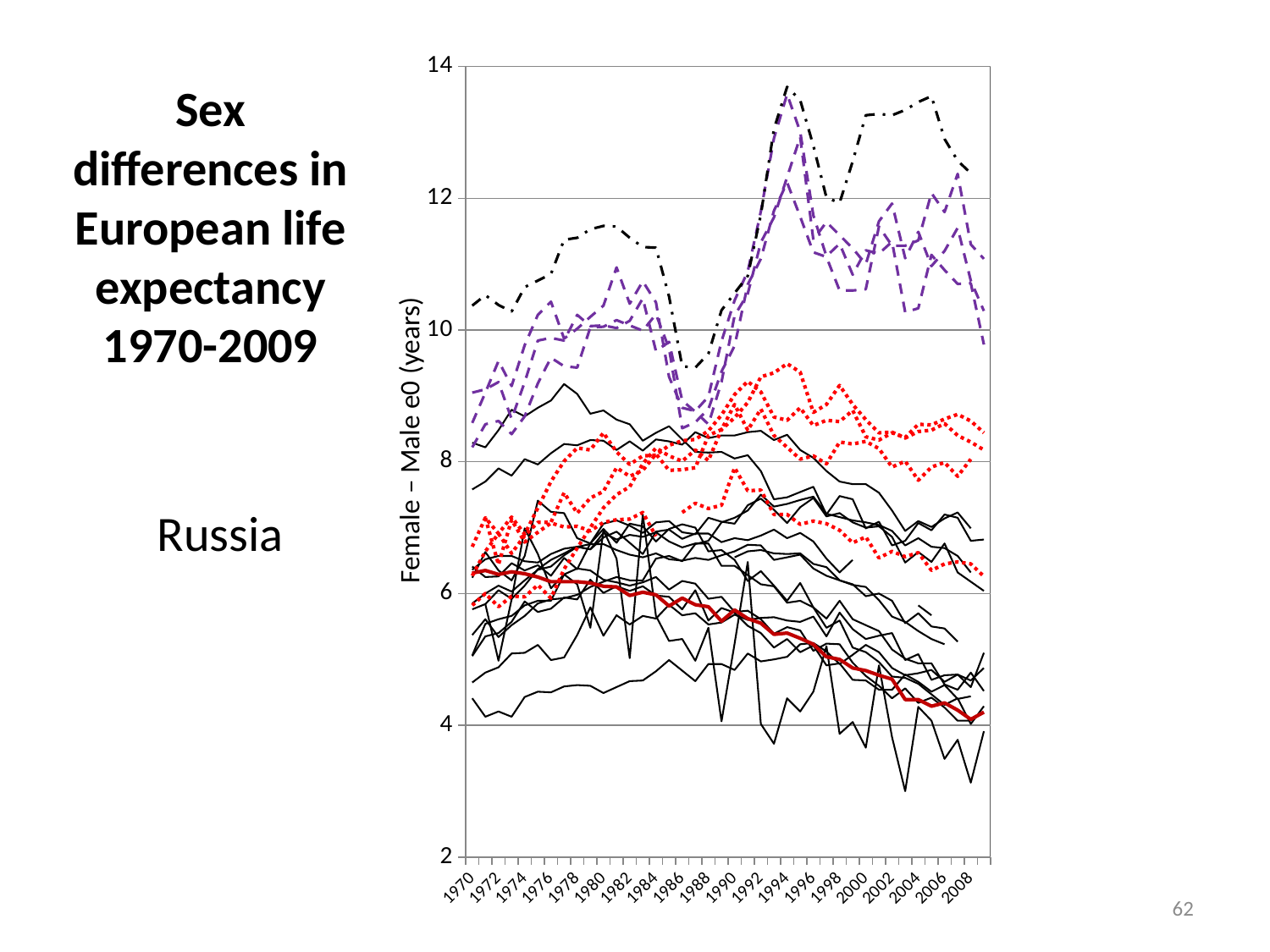
Is the peak value of the black dash-dot line around 1994 greater or less than 12? greater Which country is named on the slide as the focus of the chart? Russia What is the last year labelled on the horizontal axis of the chart? 2008 What kind of chart is shown on the slide? line chart Is the value of the black dash-dot line in 1970 greater or less than 8? greater What is the highest value shown on the vertical axis of the chart? 14 What is the label of the vertical axis of the chart? Female – Male e0 (years) Does the thick red line rise or fall overall from 1970 to 2009? fall Is the value of the thick red line in 2008 greater or less than 6? less What is the first year labelled on the horizontal axis of the chart? 1970 How many year labels are printed along the horizontal axis of the chart? 20